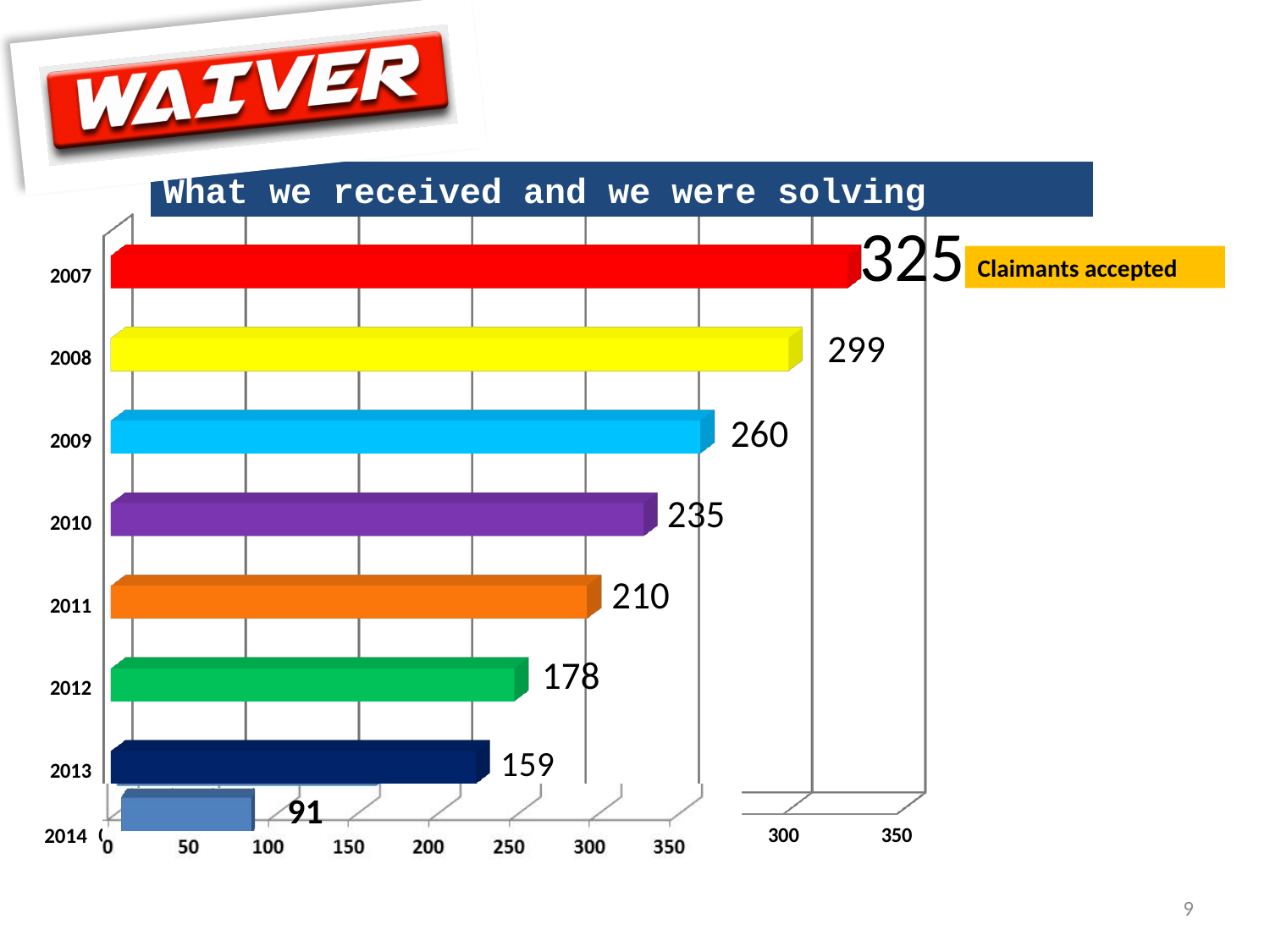
What is the difference between the values for 2008 and 2009? 39 Which year has the lowest value? 2014 Which is larger, the value for 2009 or the value for 2011? 2009 Which year has the highest value? 2007 What is the value for 2010? 235 How many years are shown on the chart? 8 What is the title of the chart? What we received and we were solving What is the difference between the values for 2011 and 2012? 32 What is the value for 2014? 91 What is the value for 2013? 159 What kind of chart is shown on the slide? bar chart What is the value for 2007? 325